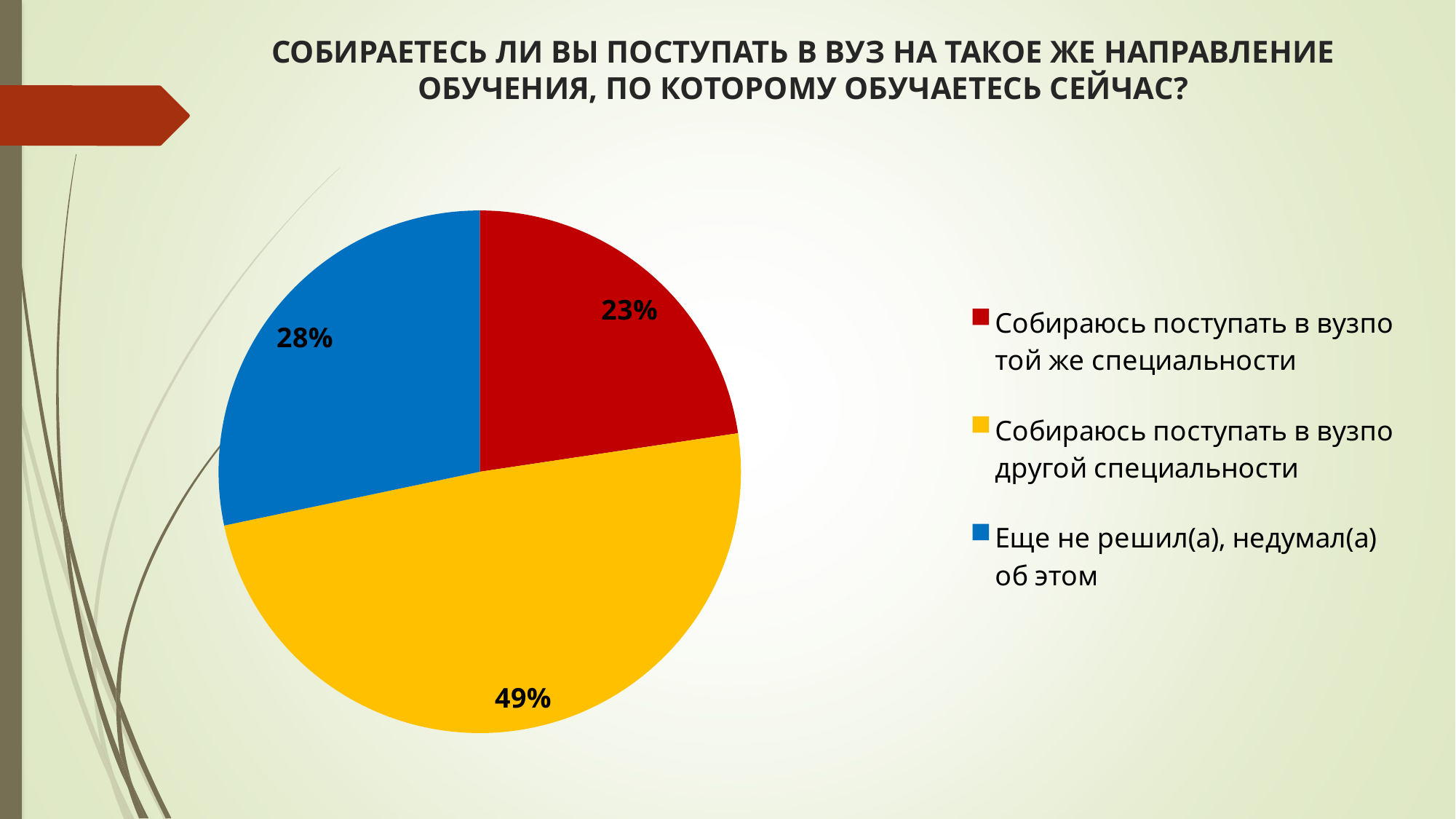
What colour is the slice for "Собираюсь поступать в вуз по другой специальности"? yellow How many slices does the pie chart have? 3 Which category has the largest slice of the pie? Собираюсь поступать в вуз по другой специальности How many entries does the legend list? 3 What is the difference in percentage points between the "Еще не решил(а)" slice and the "той же специальности" slice? 5 Which is larger: the slice for "Еще не решил(а), не думал(а) об этом" or the slice for "Собираюсь поступать в вуз по той же специальности"? Еще не решил(а), не думал(а) об этом Which category has the smallest slice of the pie? Собираюсь поступать в вуз по той же специальности What is the difference in percentage points between the "другой специальности" slice and the "той же специальности" slice? 26 What share of the pie is labelled "Собираюсь поступать в вуз по той же специальности"? 23% What kind of chart is shown on the slide? pie chart What share of the pie is labelled "Собираюсь поступать в вуз по другой специальности"? 49% What share of the pie is labelled "Еще не решил(а), не думал(а) об этом"? 28%